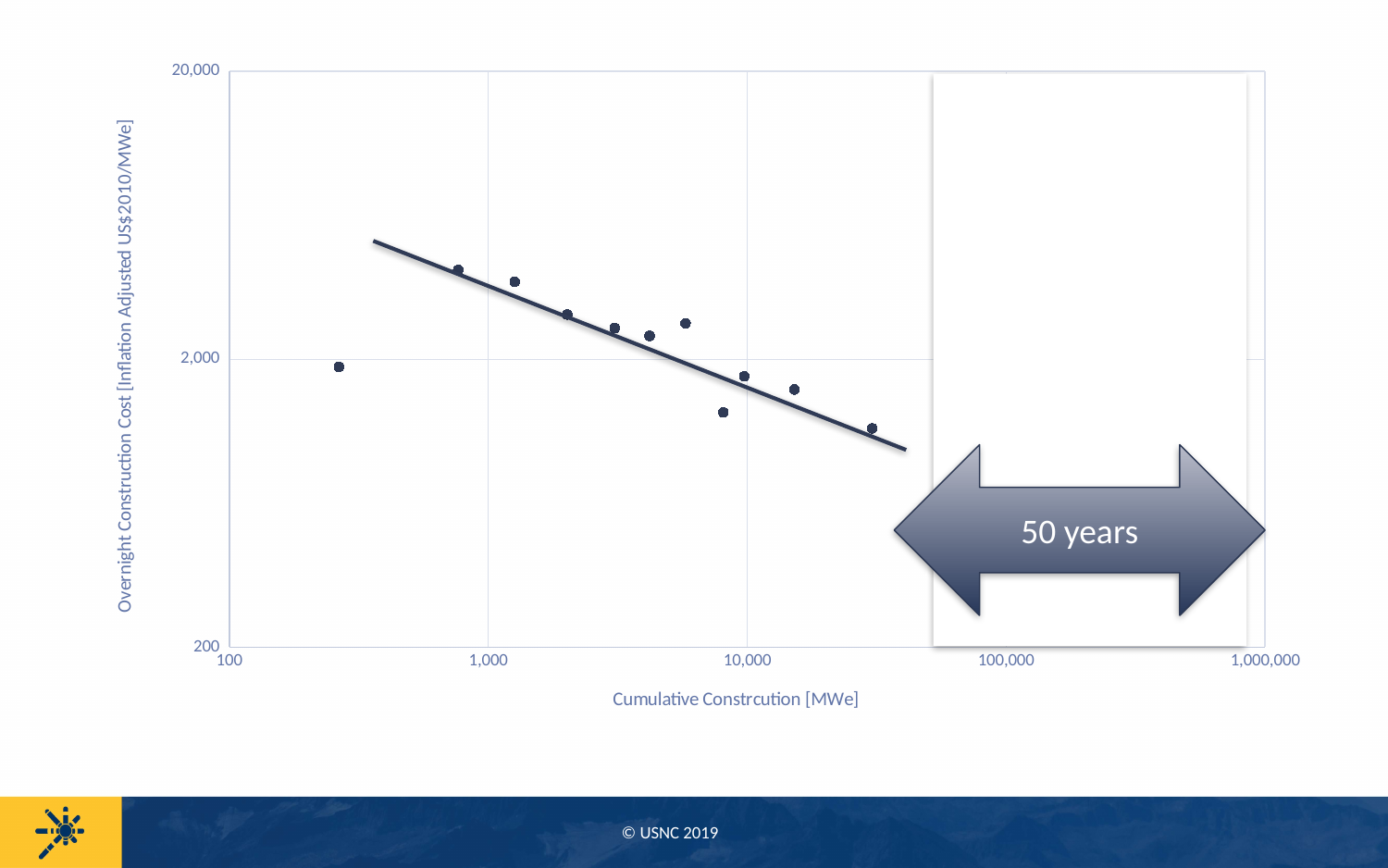
What is the highest value shown on the y axis? 20,000 Is the overnight construction cost for the point at roughly 750 MWe cumulative construction greater or less than 2,000? greater What is the title of the x axis? Cumulative Constrcution [MWe] Do the plotted values generally rise or fall as cumulative construction increases along the x axis? Fall What kind of chart is shown on the slide? Scatter chart Which is larger: the overnight construction cost for the point near 750 MWe or the point near 30,000 MWe? The point near 750 MWe Is the overnight construction cost for the point at roughly 2,000 MWe cumulative construction greater or less than 2,000? greater What is the title of the y axis? Overnight Construction Cost [Inflation Adjusted US$2010/MWe] Is the overnight construction cost for the point at roughly 30,000 MWe cumulative construction greater or less than 2,000? less